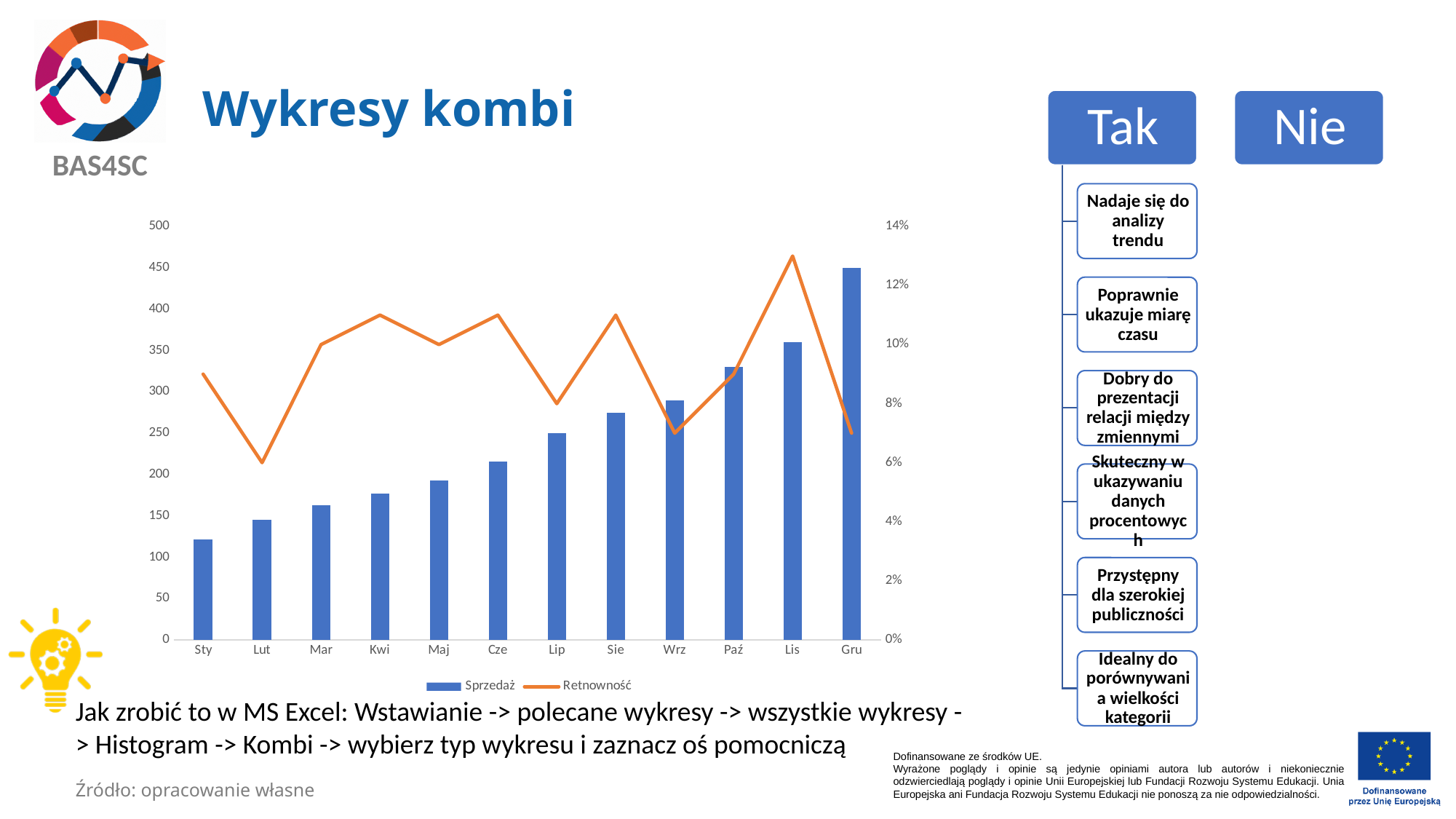
Which has the larger Sprzedaż value, Paź or Lip? Paź Do the Sprzedaż bars rise or fall from Sty to Gru? Rise How many series does the chart legend list? 2 In which month does the Retnowność line reach its lowest point? Lut In which month does the Retnowność line reach its highest point? Lis Is the Sprzedaż value for Gru greater or less than 400? greater Which month has the highest Sprzedaż bar? Gru Is the Retnowność value for Lis greater or less than 12%? greater Which month has the lowest Sprzedaż bar? Sty What kind of chart is shown on the slide? A combination bar and line chart Is the Sprzedaż value for Sty greater or less than 150? less How many months are shown on the x axis of the chart? 12